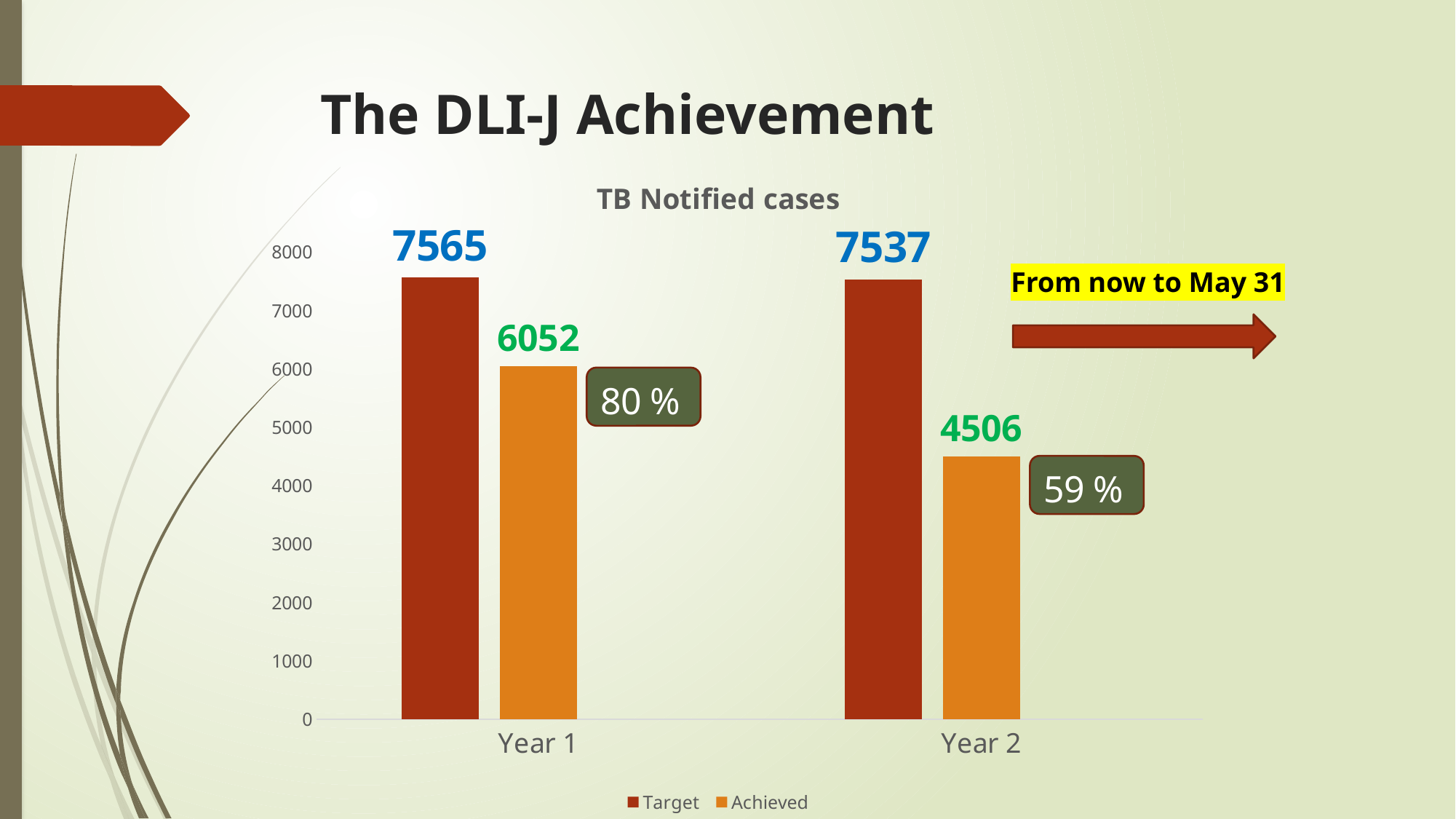
What is the difference between the Target and Achieved values for Year 2? 3031 What is the Achieved value for Year 2? 4506 What is the title of the chart? TB Notified cases What kind of chart is shown on the slide? Bar chart How many categories are shown on the x axis? 2 What is the difference between the Target and Achieved values for Year 1? 1513 Which is larger, the Achieved value for Year 1 or the Achieved value for Year 2? Year 1 What is the Target value for Year 2? 7537 What is the Achieved value for Year 1? 6052 How many series does the legend list? 2 Which year has the lower Achieved value? Year 2 What is the Target value for Year 1? 7565